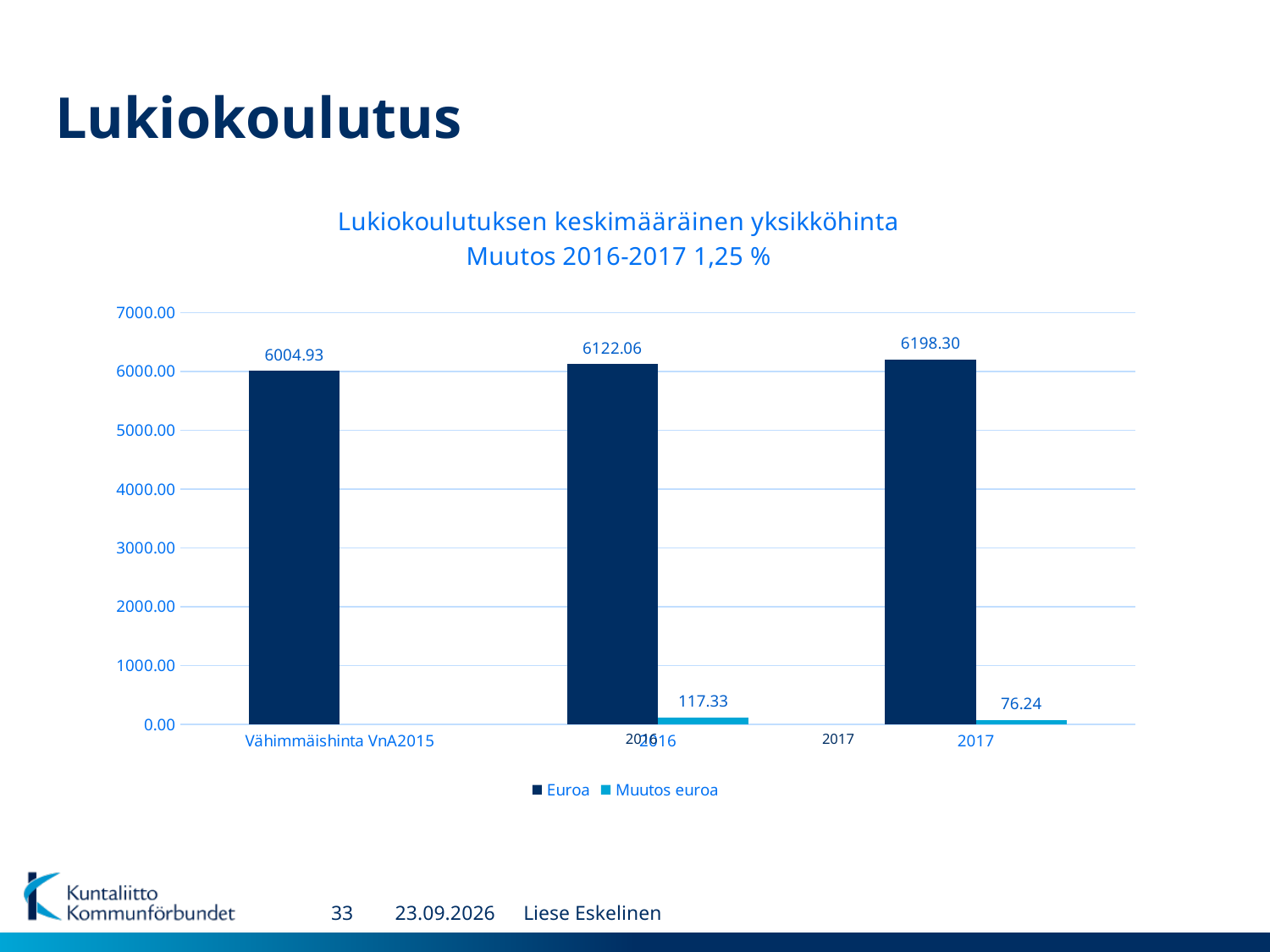
Which category has the highest Euroa value? 2017 What is the Euroa value for Vähimmäishinta VnA2015? 6004.93 What is the Muutos euroa value for 2017? 76.24 Which category has the lowest Euroa value? Vähimmäishinta VnA2015 What is the Muutos euroa value for 2016? 117.33 What kind of chart is shown on the slide? Bar chart How many series does the legend list? 2 Is the Euroa value for Vähimmäishinta VnA2015 greater or less than 6000.00? greater Which is larger, the Muutos euroa value for 2016 or for 2017? 2016 What is the difference between the Euroa values for 2017 and 2016? 76.24 What is the Euroa value for 2017? 6198.30 What is the Euroa value for 2016? 6122.06